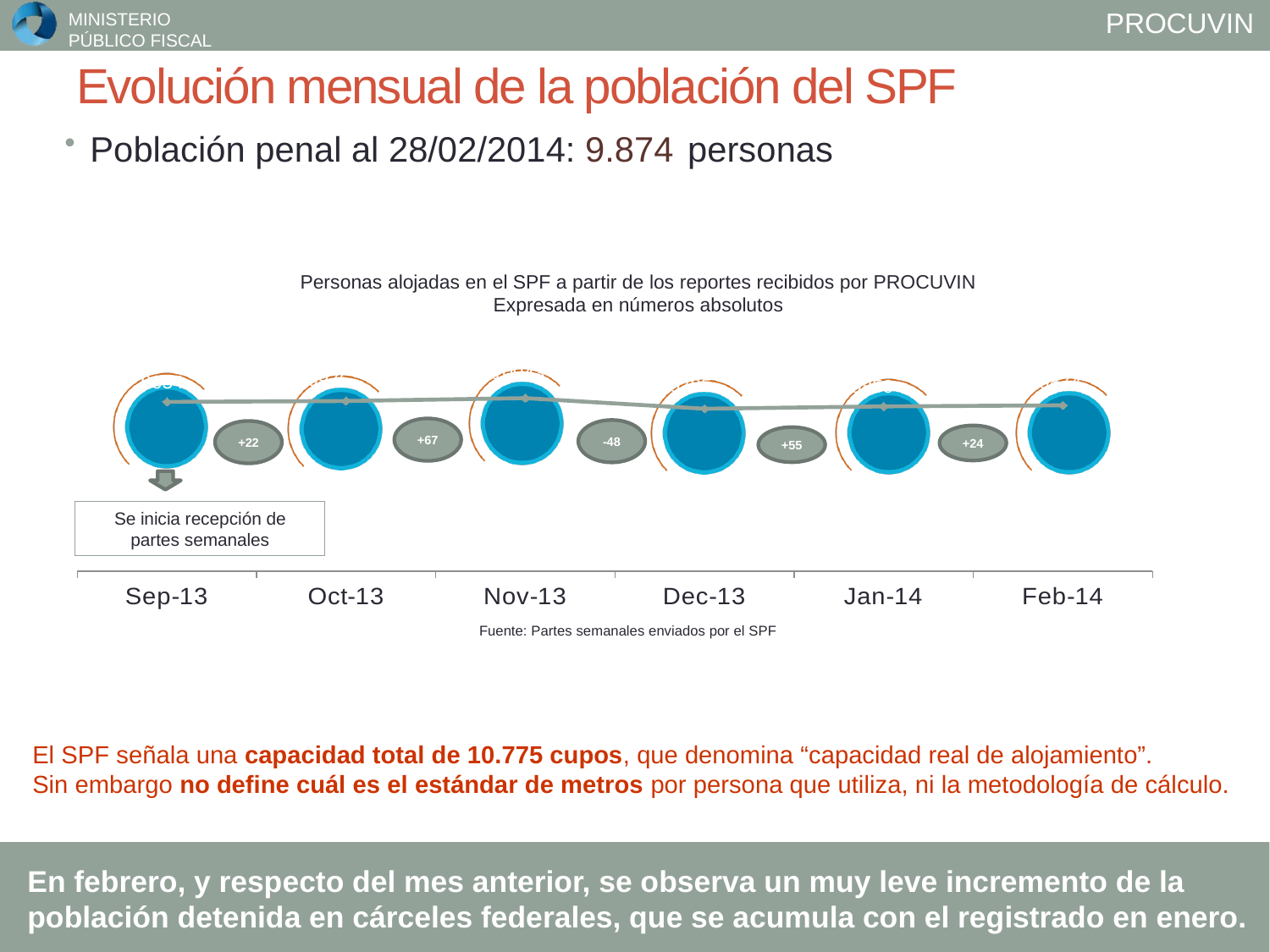
What is the change in population shown between Dec-13 and Jan-14? +55 What kind of chart is used to show the evolution of the SPF population? Line chart What is the change in population shown between Sep-13 and Oct-13? +22 Which month-to-month change is the largest increase shown on the chart? Oct-13 to Nov-13 (+67) What is the change in population shown between Nov-13 and Dec-13? -48 How many months are shown along the x axis of the chart? 6 Does the line rise or fall from Nov-13 to Dec-13? Fall Which month-to-month change is the only decrease shown on the chart? Nov-13 to Dec-13 (-48) What is the change in population shown between Oct-13 and Nov-13? +67 According to the chart's source note, where does the data come from? Partes semanales enviados por el SPF What is the change in population shown between Jan-14 and Feb-14? +24 What is the first month shown on the x axis of the chart? Sep-13